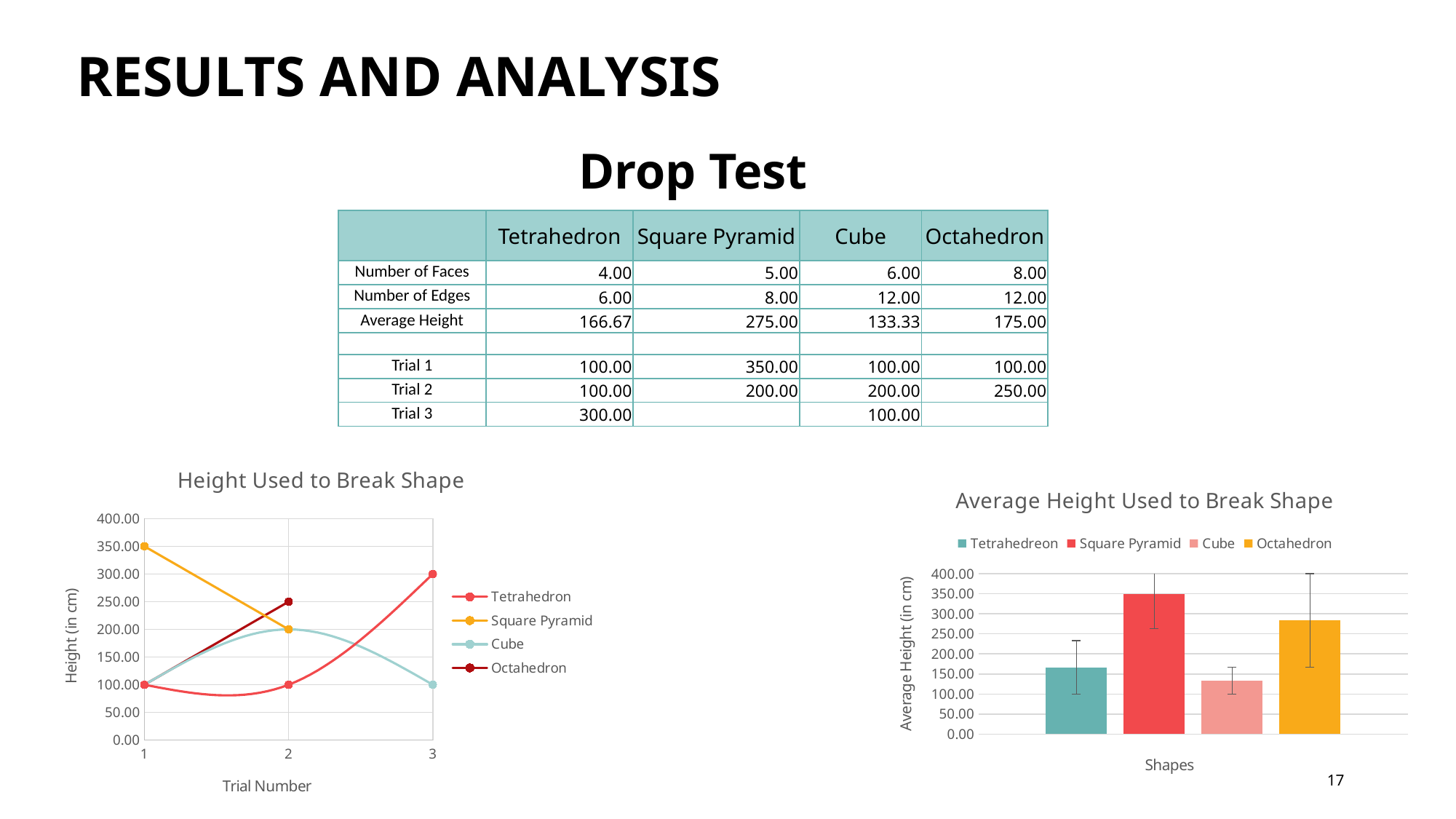
In the 'Height Used to Break Shape' chart, what is the value for Tetrahedron at trial 3? 300.00 In the 'Height Used to Break Shape' chart, what is the value for Cube at trial 2? 200.00 In the 'Height Used to Break Shape' chart, does the Square Pyramid line rise or fall from trial 1 to trial 2? fall In the 'Height Used to Break Shape' chart, what is the value for Square Pyramid at trial 1? 350.00 In the 'Average Height Used to Break Shape' chart, which shape has the lowest bar? Cube In the 'Height Used to Break Shape' chart, what is the value for Octahedron at trial 2? 250.00 In the 'Average Height Used to Break Shape' chart, is the value for Octahedron greater or less than 250.00? greater In the 'Average Height Used to Break Shape' chart, which shape has the highest bar? Square Pyramid What type of chart is the 'Average Height Used to Break Shape' chart? bar chart In the 'Height Used to Break Shape' chart, how many series does the legend list? 4 In the 'Height Used to Break Shape' chart, what is the difference between the Square Pyramid value at trial 1 and at trial 2? 150.00 What type of chart is the 'Height Used to Break Shape' chart? line chart